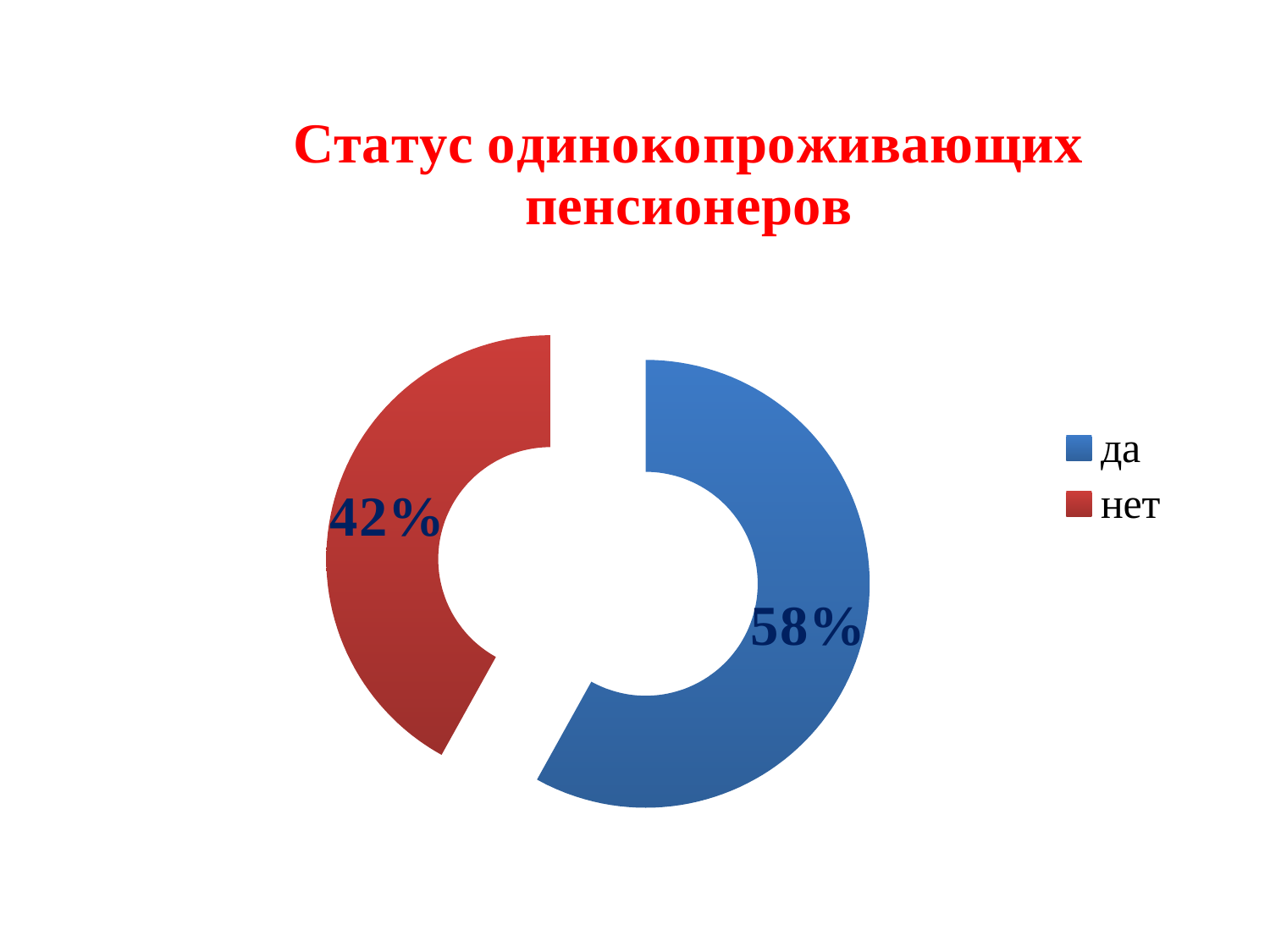
How many entries does the legend list? 2 What kind of chart is shown on the slide? Doughnut (pie) chart Which category has the smallest share? нет What percentage is shown for the "нет" slice? 42% How many categories does the chart show? 2 What is the difference in percentage points between the "да" and "нет" slices? 16 Which slice is larger, "да" or "нет"? да Which category has the largest share? да Is the share for "да" greater or less than 50%? greater What is the title of the chart? Статус одинокопроживающих пенсионеров What percentage is shown for the "да" slice? 58% What colour is the "нет" slice? Red